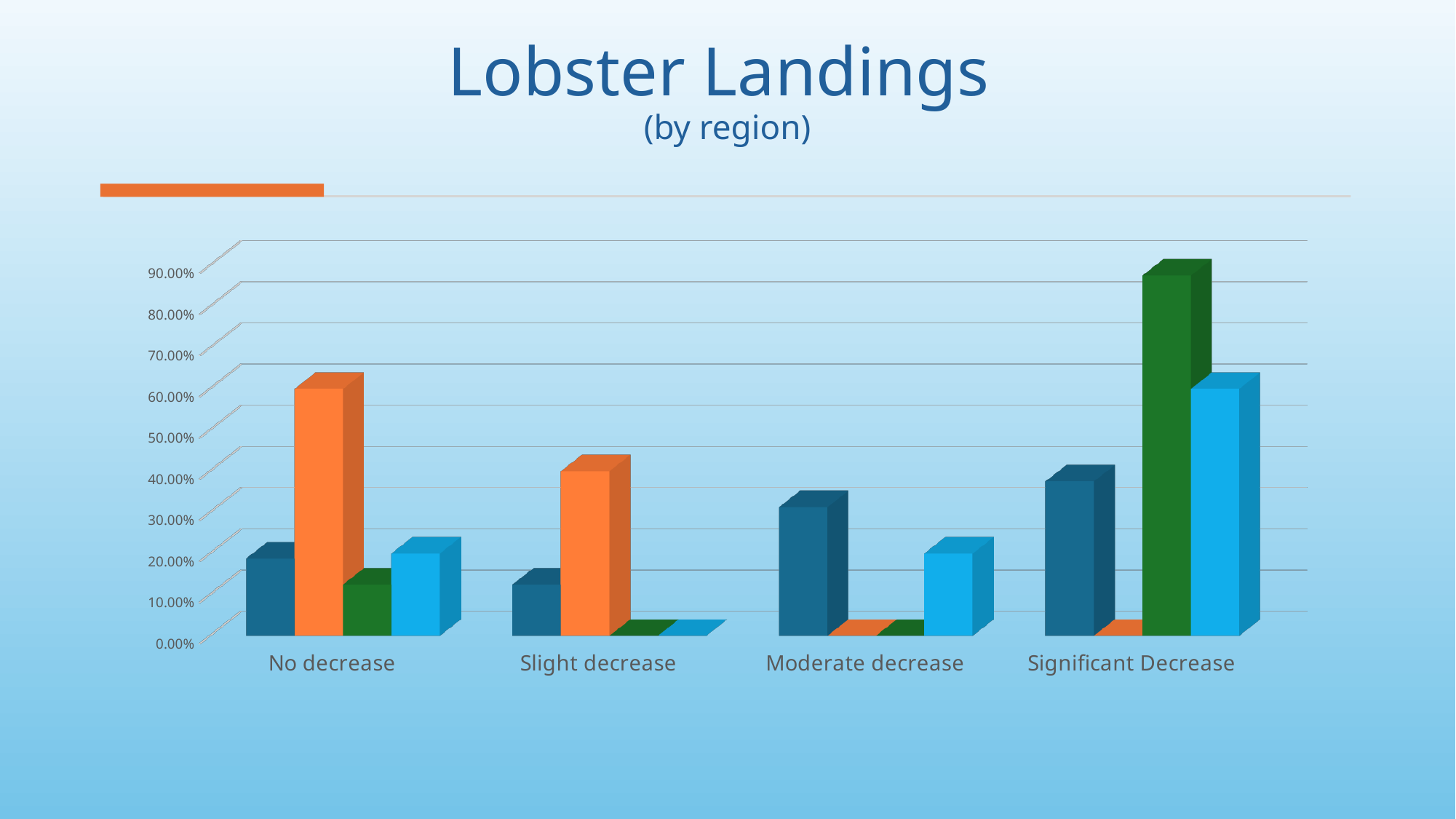
Which category contains the tallest bar in the chart? Significant Decrease Is the dark blue bar for No decrease greater or less than 30.00%? less How many categories are shown along the x axis of the chart? 4 How many bars are plotted for each category in the chart? 4 Which is larger, the orange bar for No decrease or the orange bar for Slight decrease? No decrease Is the green bar for Significant Decrease greater or less than 70.00%? greater Which category has the tallest dark blue bar? Significant Decrease What kind of chart is shown on the slide? Bar chart Is the orange bar for No decrease greater or less than 50.00%? greater Which category has the tallest orange bar? No decrease What is the title of the chart on the slide? Lobster Landings